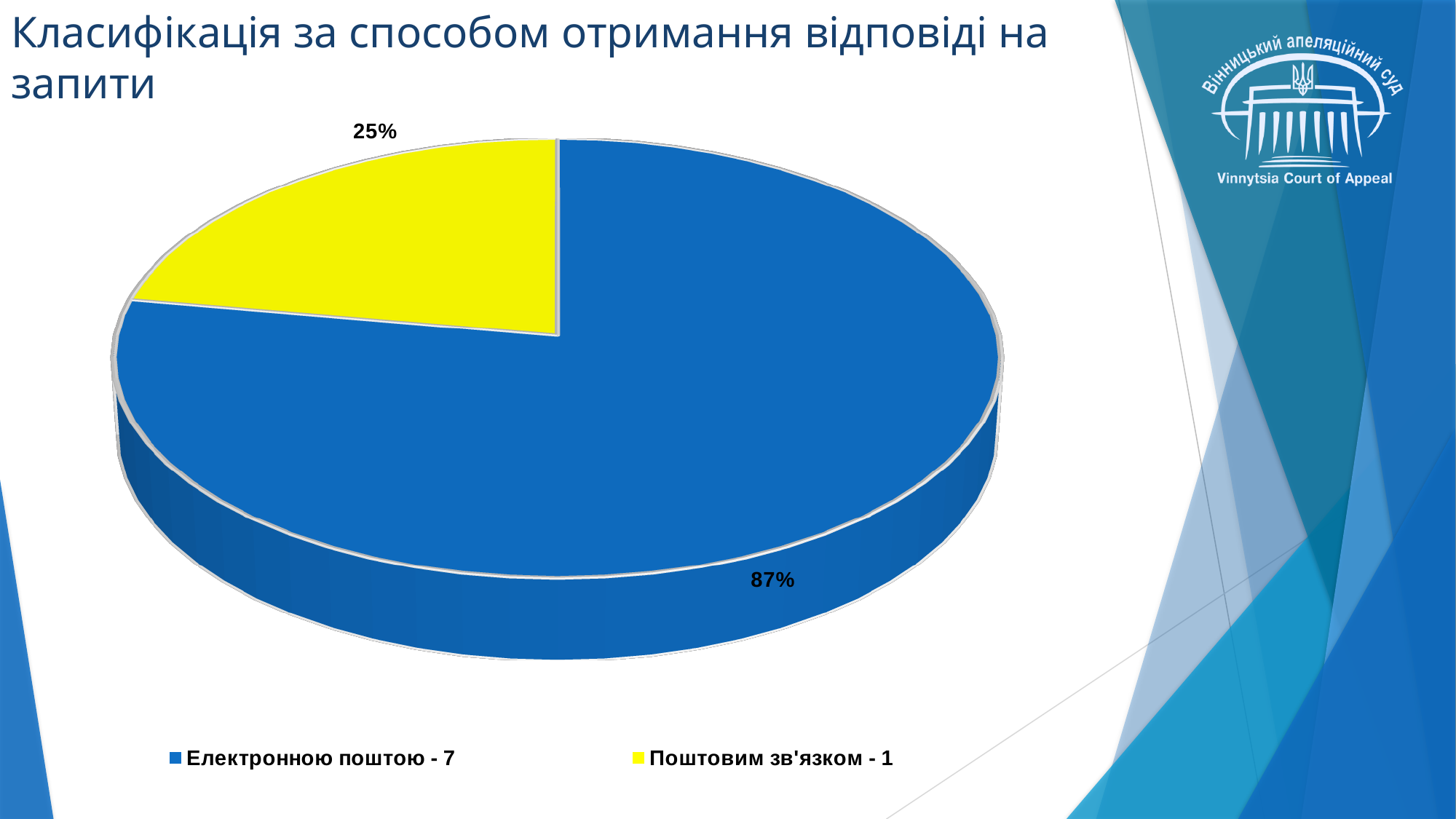
How many entries does the legend list? 2 What count is given in the legend for Електронною поштою? 7 What count is given in the legend for Поштовим зв'язком? 1 What colour is the slice for Поштовим зв'язком? yellow What kind of chart is shown on the slide? pie chart What percentage label is shown on the blue slice (Електронною поштою)? 87% What percentage label is shown on the yellow slice (Поштовим зв'язком)? 25% Which category has the smallest slice of the pie? Поштовим зв'язком What is the title of the slide containing the pie chart? Класифікація за способом отримання відповіді на запити How many slices does the pie chart have? 2 Which slice is larger: Електронною поштою or Поштовим зв'язком? Електронною поштою Which category has the largest slice of the pie? Електронною поштою